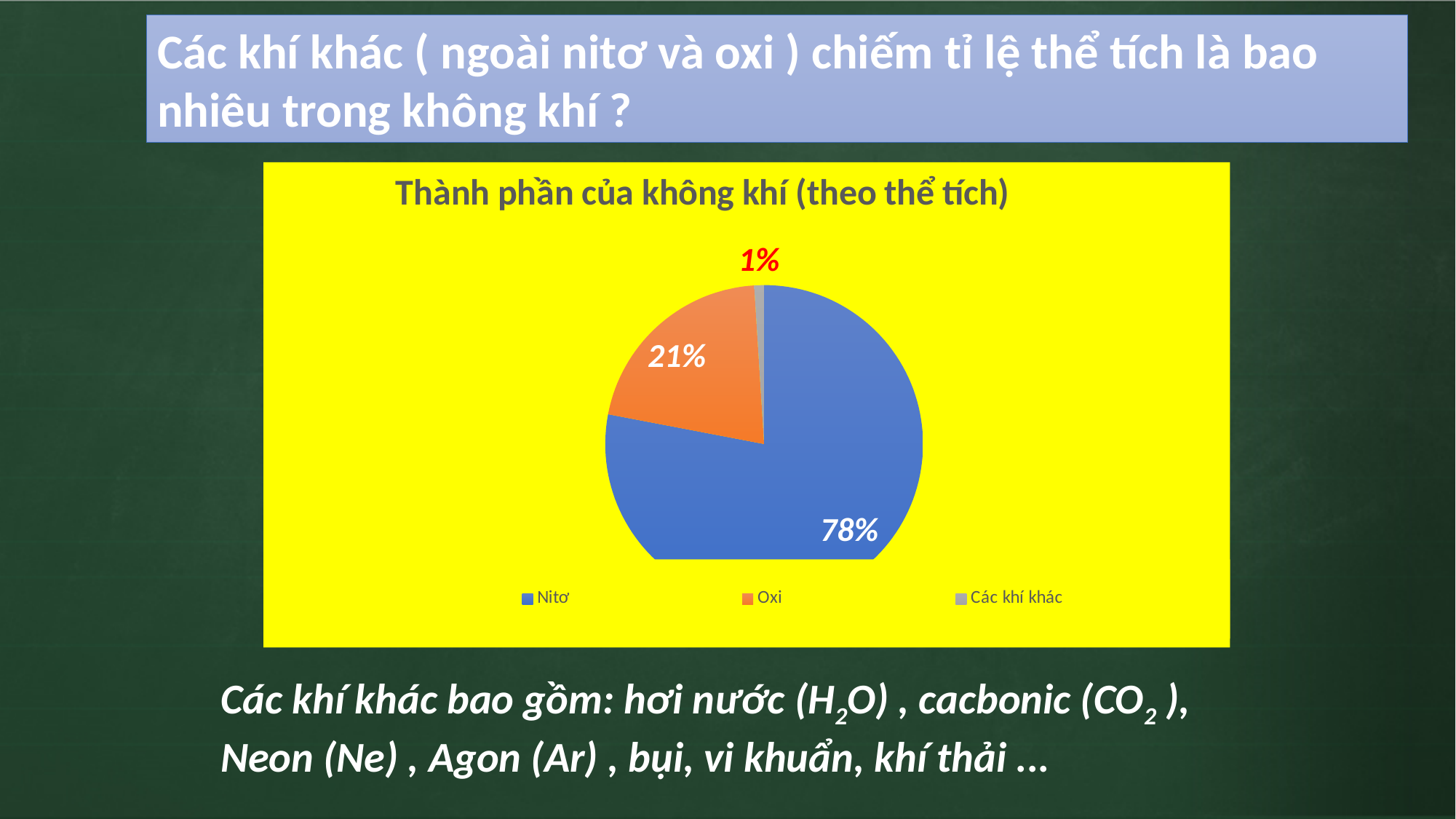
How many categories does the legend list? 3 Which category has the largest slice of the pie? Nitơ What is the combined share of Oxi and Các khí khác? 22% What type of chart is shown on the slide? pie chart What is the title of the chart? Thành phần của không khí (theo thể tích) What percentage of the pie does Oxi represent? 21% Which is larger, the share for Oxi or the share for Các khí khác? Oxi What is the difference in percentage points between Nitơ and Oxi? 57 What percentage of the pie does Nitơ represent? 78% What percentage of the pie does Các khí khác represent? 1% What colour is the slice for Oxi? orange Which category has the smallest slice of the pie? Các khí khác